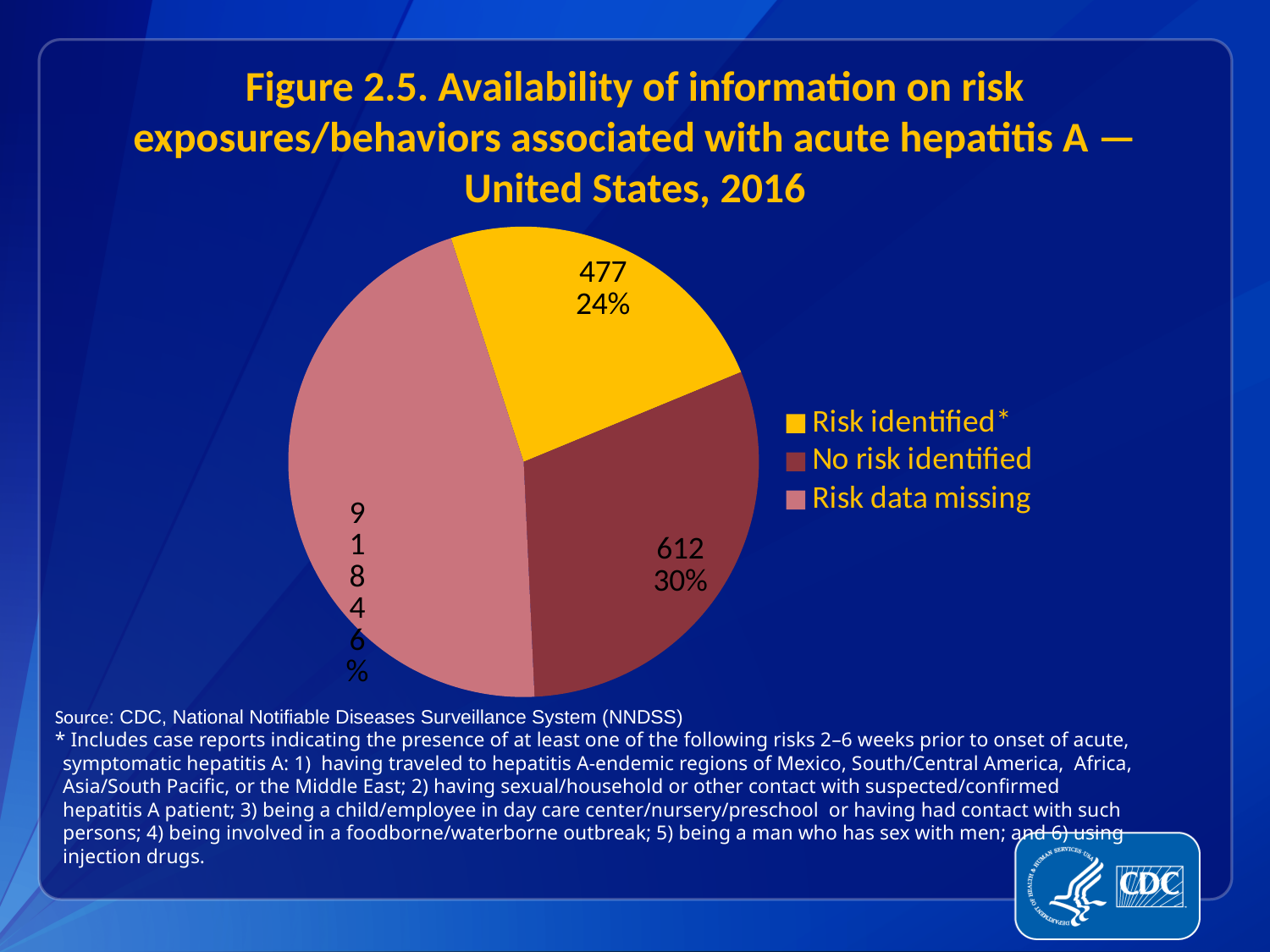
What percentage of the pie is the 'Risk identified*' slice? 24% Which is larger, the 'No risk identified' slice or the 'Risk identified*' slice? No risk identified How many categories does the legend list? 3 Which category has the largest slice of the pie? Risk data missing What year does the chart title say the data is for? 2016 What colour is the 'Risk data missing' slice? Pink How many cases are in the 'No risk identified' slice? 612 How many cases are in the 'Risk identified*' slice? 477 How many more cases are in the 'No risk identified' slice than in the 'Risk identified*' slice? 135 What kind of chart is shown on the slide? Pie chart Which category has the smallest slice of the pie? Risk identified* What percentage of the pie is the 'No risk identified' slice? 30%